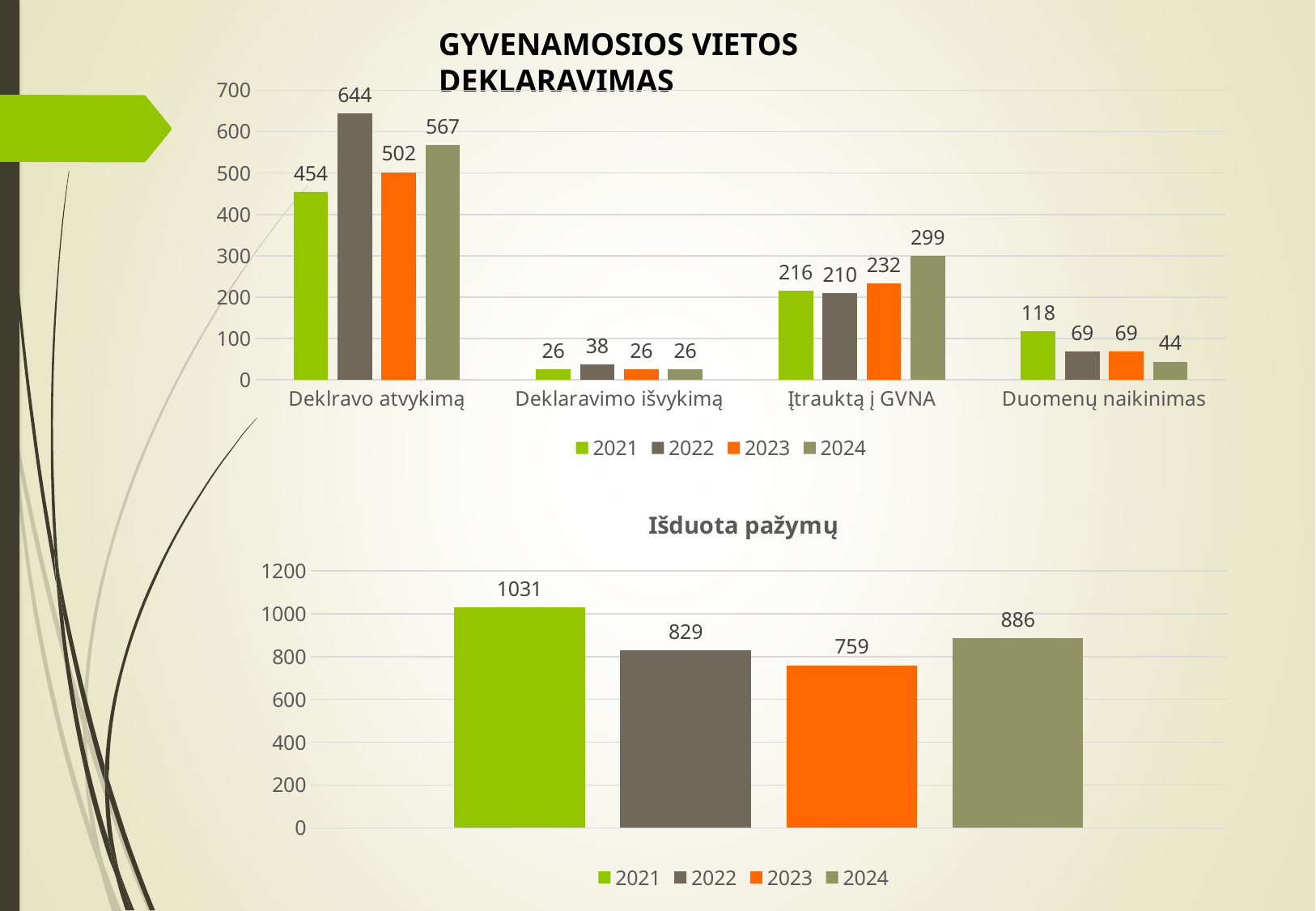
In the top chart, how many series does the legend list? 4 What kind of chart is the bottom chart (Išduota pažymų)? bar chart In the top chart, how many categories are shown on the x axis? 4 In the bottom chart (Išduota pažymų), is the value for 2022 larger or smaller than the value for 2024? smaller In the top chart, which year has the lowest value in the Deklravo atvykimą category? 2021 In the top chart, what is the difference between the 2022 and 2021 values in the Deklravo atvykimą category? 190 In the top chart, which year has the highest value in the Duomenų naikinimas category? 2021 In the bottom chart (Išduota pažymų), what is the difference between the 2021 and 2024 values? 145 In the bottom chart (Išduota pažymų), which year has the highest value? 2021 In the top chart, what is the value for 2024 in the Įtraukta į GVNA category? 299 In the bottom chart (Išduota pažymų), what is the value for 2023? 759 In the top chart (Gyvenamosios vietos deklaravimas), what is the value for 2022 in the Deklravo atvykimą category? 644